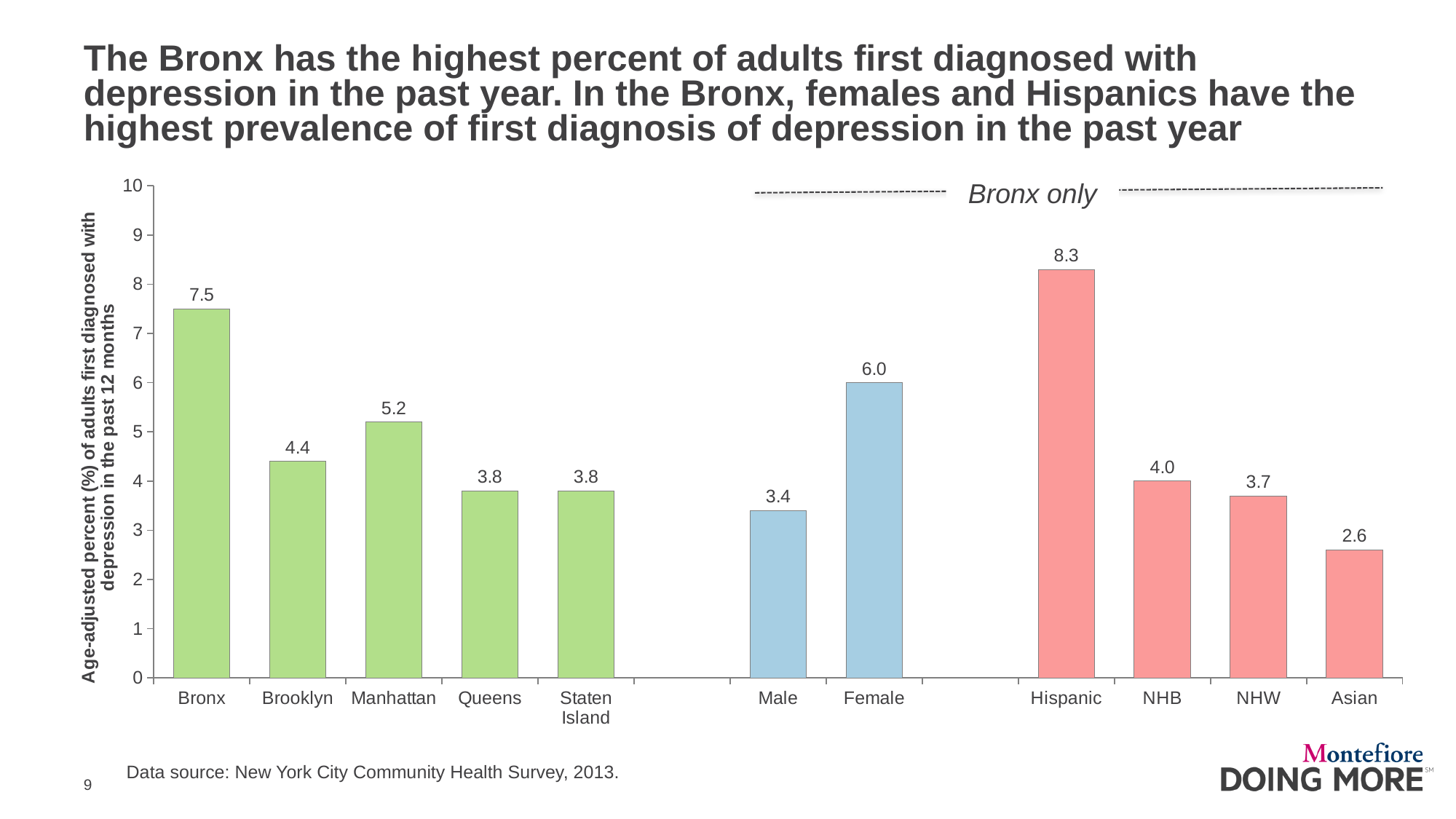
What is the value shown for Asian? 2.6 What is the difference between the Female and Male values? 2.6 Which category has the highest value on the chart? Hispanic What is the difference between the Bronx and Brooklyn values? 3.1 Is the value for Hispanic greater or less than 8? greater How many bars are plotted on the chart? 11 What is the data source cited on the slide? New York City Community Health Survey, 2013 What is the value shown for Female in the Bronx-only section? 6.0 What kind of chart is shown on the slide? Bar chart Which borough has the lowest value among the five boroughs? Queens and Staten Island (3.8) What is the age-adjusted percent of adults first diagnosed with depression in the past 12 months for the Bronx? 7.5 Which is larger, the value for Manhattan or the value for NHB? Manhattan